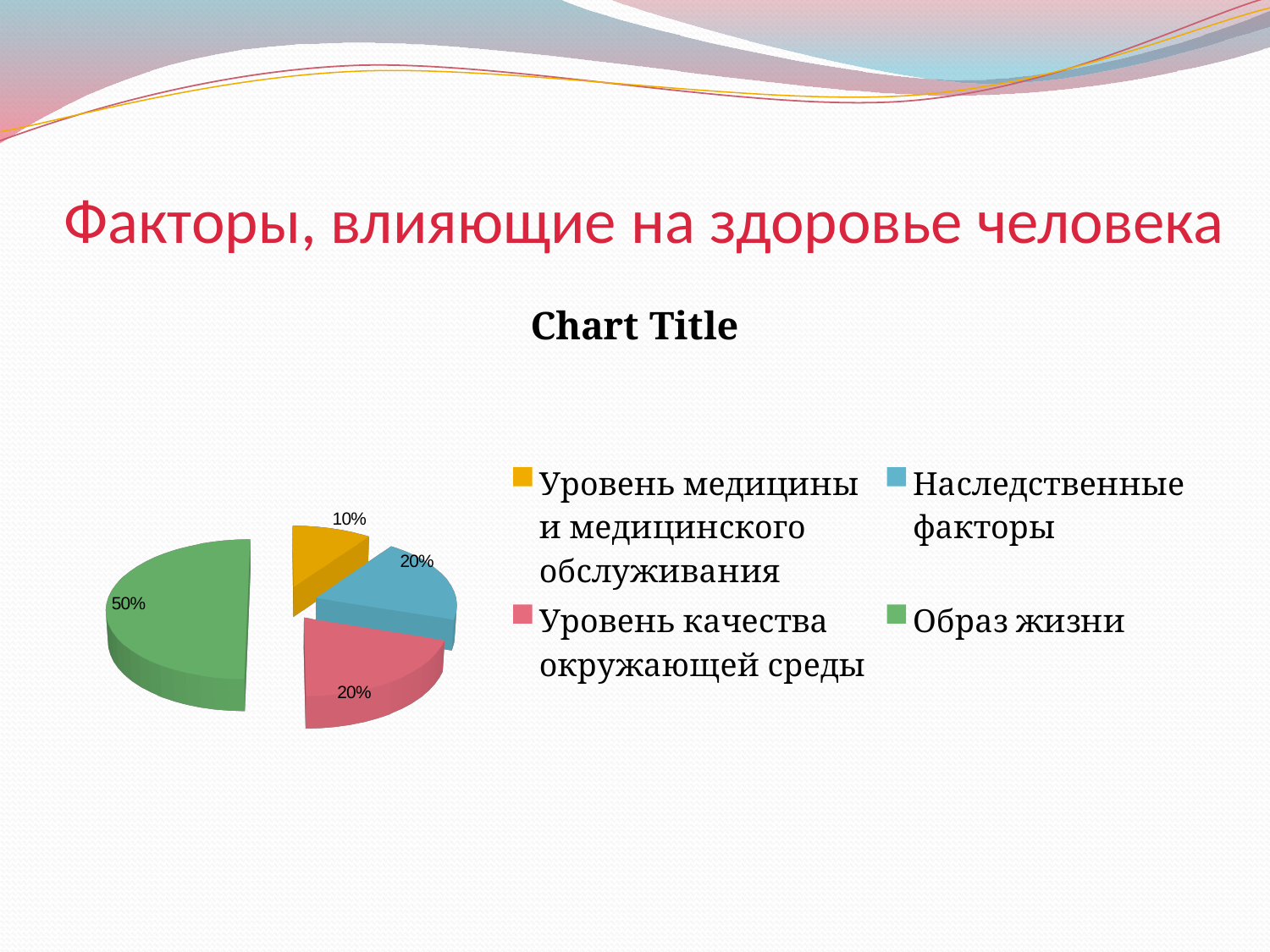
Which is larger: the share for "Образ жизни" or the share for "Наследственные факторы"? Образ жизни Which category has the largest slice of the pie? Образ жизни What is the value shown for "Уровень медицины и медицинского обслуживания"? 10% What is the value shown for "Уровень качества окружающей среды"? 20% Which category has the smallest slice of the pie? Уровень медицины и медицинского обслуживания What share of the pie does "Образ жизни" take? 50% What is the difference between the share for "Образ жизни" and the share for "Уровень медицины и медицинского обслуживания"? 40% What is the value shown for "Наследственные факторы"? 20% How many slices does the pie chart have? 4 What is the title printed above the pie chart? Chart Title What kind of chart is shown on the slide? pie chart What colour is the slice for "Образ жизни"? green